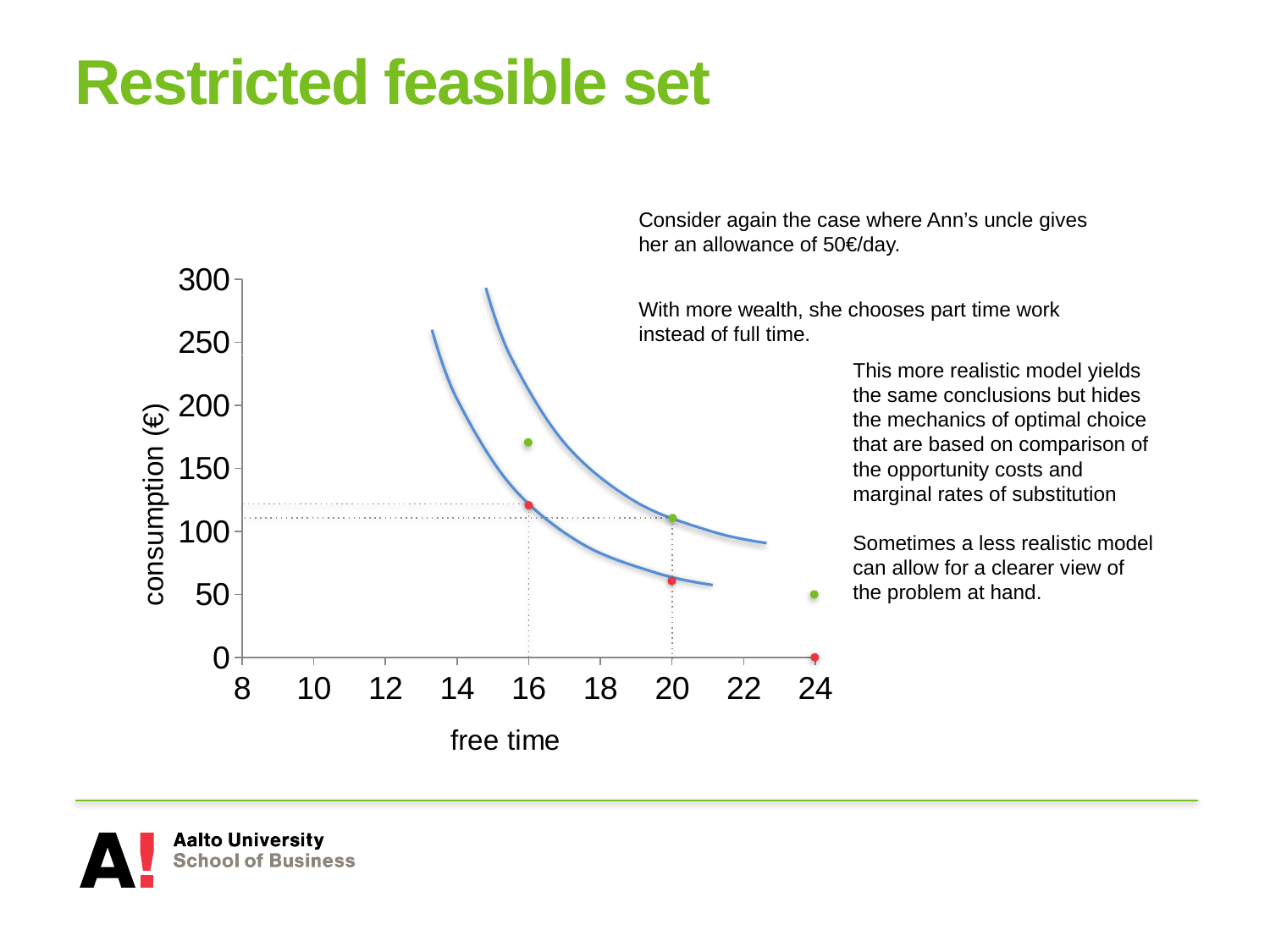
What is the label of the horizontal axis of the chart? free time Which has the higher consumption value: the green point at 16 hours of free time or the red point at 16 hours of free time? the green point How many red points are plotted on the chart? 3 How many plotted points (red and green dots) are shown on the chart? 6 Is the consumption value of the red point at 20 hours of free time greater or less than 100? less What is the highest value shown on the vertical axis of the chart? 300 Is the consumption value of the red point at 16 hours of free time greater or less than 100? greater How many blue curves are drawn on the chart? 2 Is the consumption value of the green point at 16 hours of free time greater or less than 150? greater What is the label of the vertical axis of the chart? consumption (€) Do the blue curves rise or fall as free time increases? fall What is the consumption value of the red point at 24 hours of free time? 0